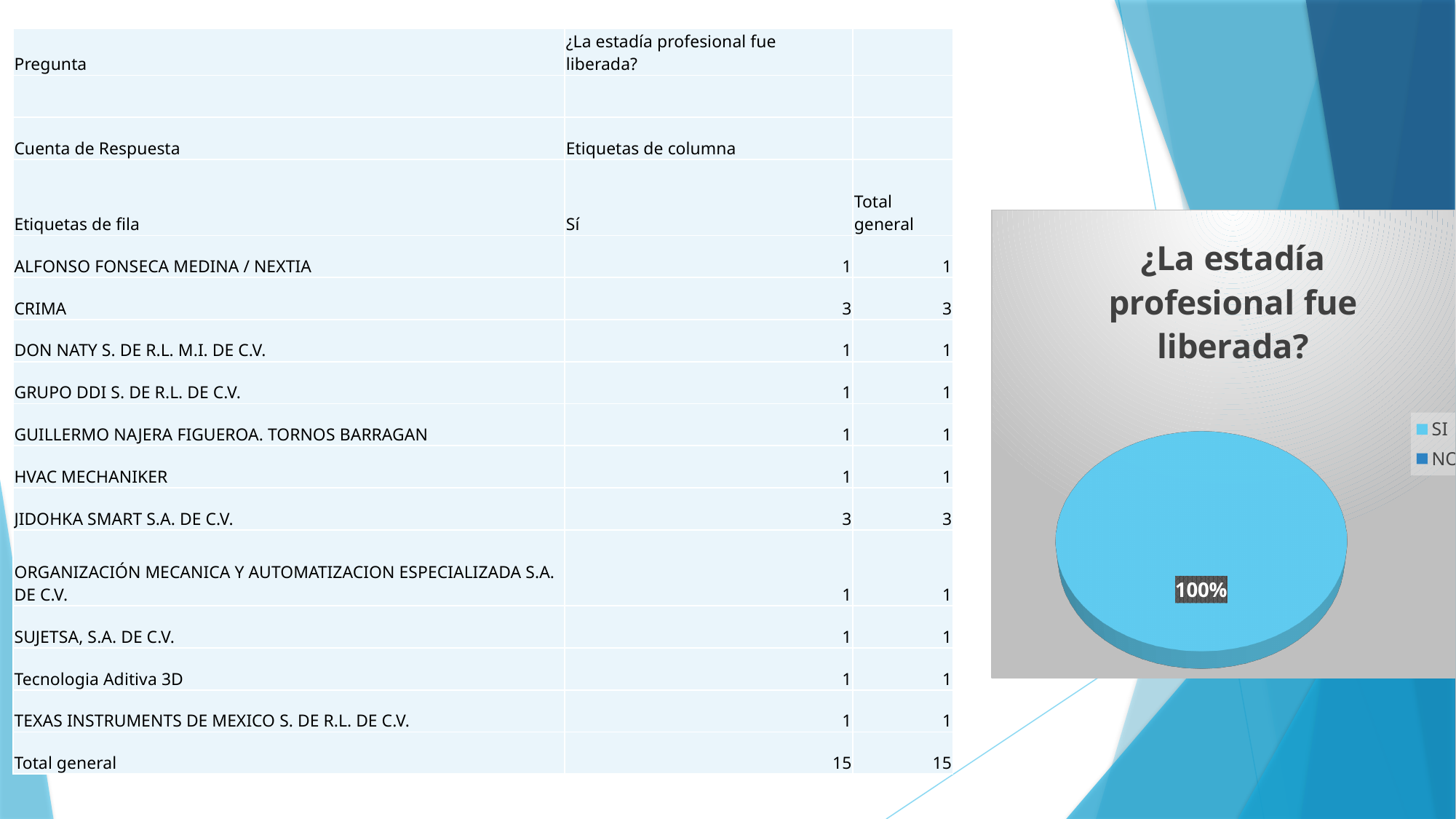
How many entries does the legend of the pie chart list? 2 In the pie chart, what share of the pie does the SI slice represent? 100% What colour is the SI slice in the pie chart? light blue What kind of chart is shown on the right side of the slide? pie chart What data label is printed on the pie chart? 100% What is the title of the pie chart? ¿La estadía profesional fue liberada? Which category has the largest slice in the pie chart? SI How many slices are visible in the pie chart? 1